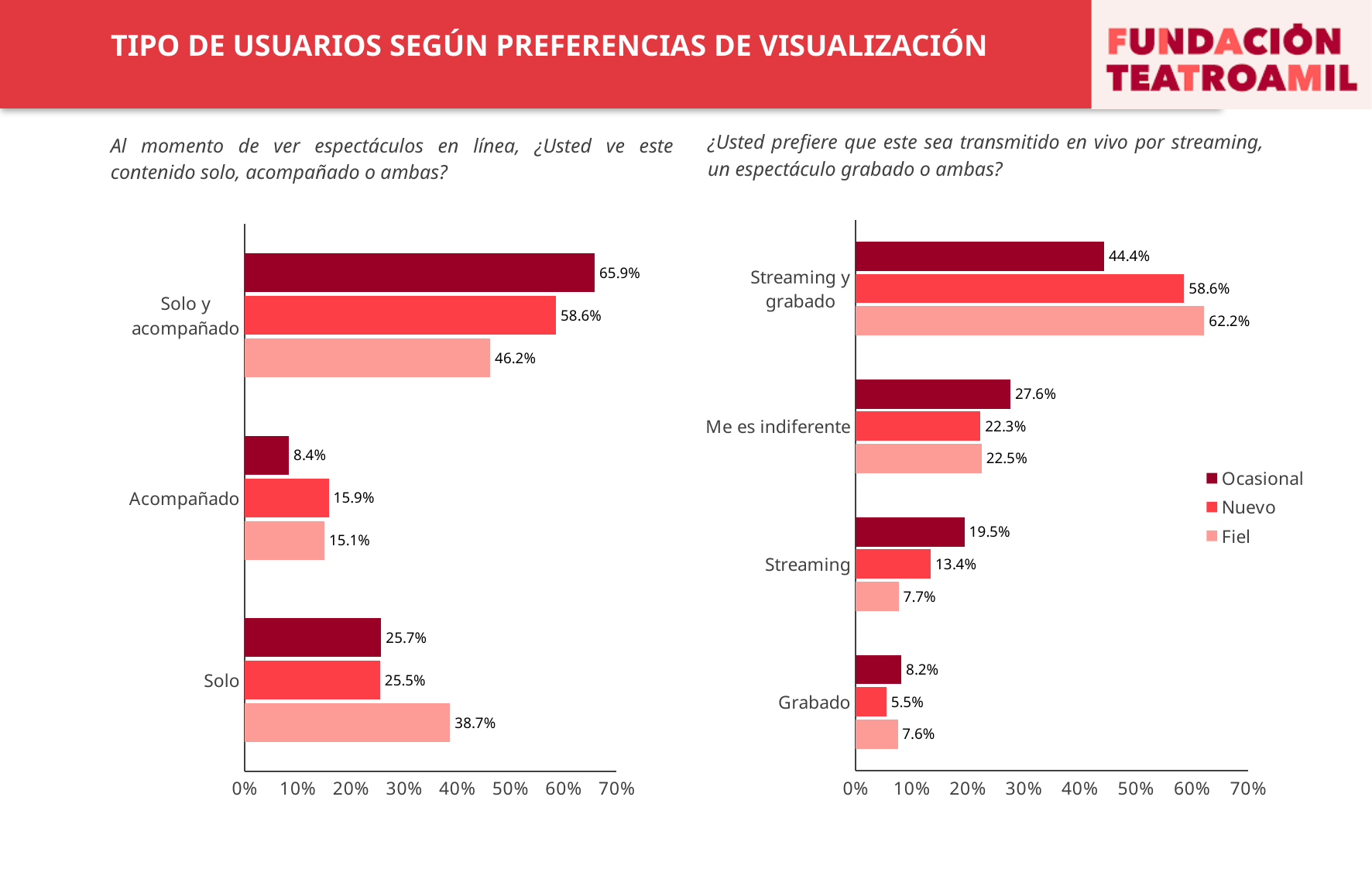
In the right chart, which category has the lowest value for Nuevo? Grabado In the left chart, what is the value for Nuevo in the 'Acompañado' category? 15.9% In the right chart, what is the difference between the Fiel and Ocasional values for 'Streaming y grabado'? 17.8% In the left chart, which category has the highest value for Fiel? Solo y acompañado How many series does the legend list? 3 What kind of chart is the left chart? Bar chart In the right chart, what is the value for Fiel in the 'Streaming y grabado' category? 62.2% In the left chart, what is the value for Ocasional in the 'Solo y acompañado' category? 65.9% In the right chart, is the value for Ocasional in 'Me es indiferente' greater or less than 20%? greater In the left chart, which is larger for the 'Solo' category: Ocasional or Fiel? Fiel Which series is shown in the darkest colour in the legend? Ocasional How many categories are shown in the right chart? 4